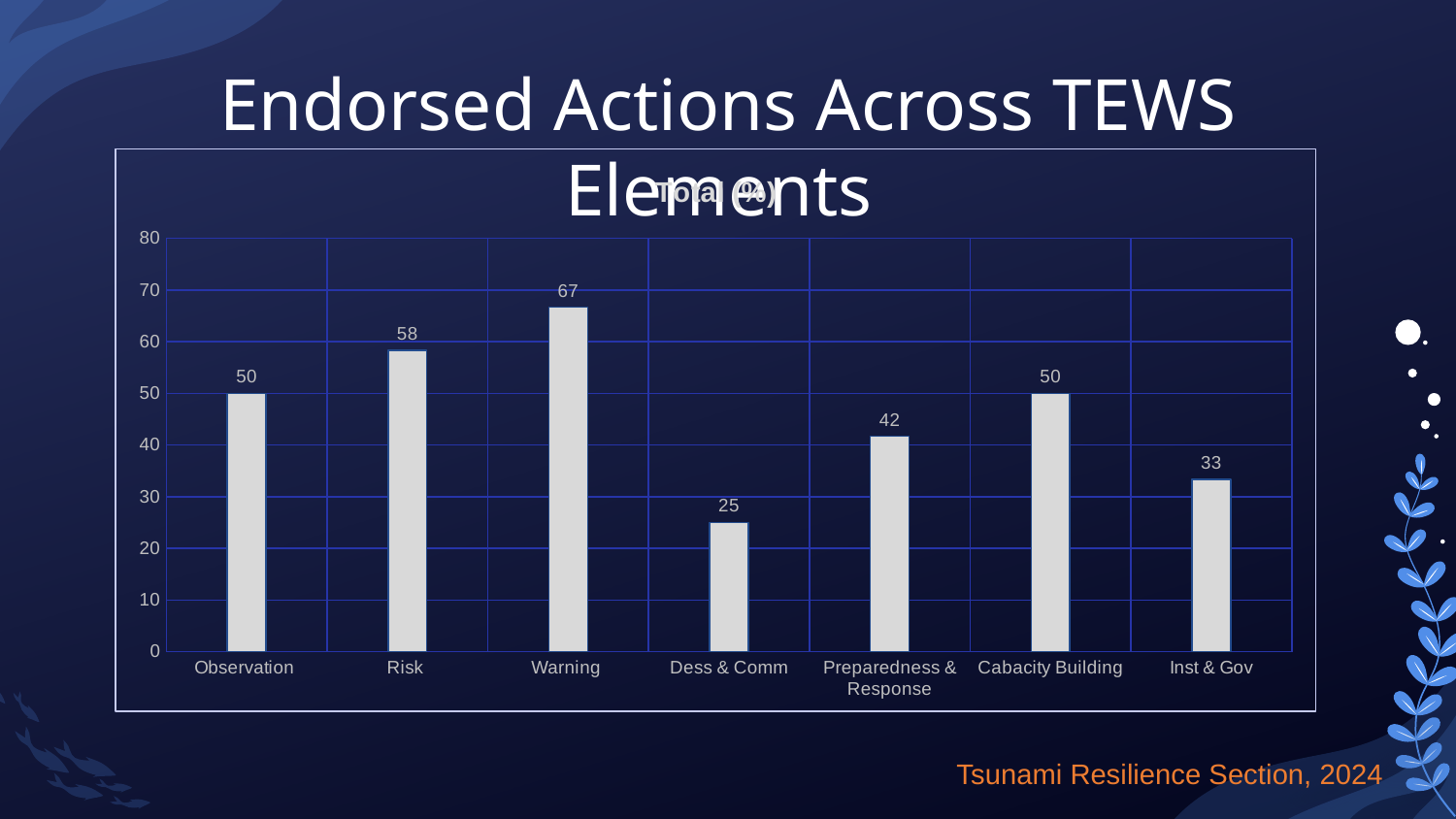
What kind of chart is shown on the slide? Bar chart Which is larger, the value for Risk or the value for Cabacity Building? Risk How many categories are shown on the x axis? 7 What is the difference between the values for Warning and Risk? 9 Which category has the highest value? Warning What is the value for Preparedness & Response? 42 What is the difference between the values for Preparedness & Response and Dess & Comm? 17 What is the value for Inst & Gov? 33 What is the value for Dess & Comm? 25 Which category has the lowest value? Dess & Comm What is the title of the slide? Endorsed Actions Across TEWS Elements What is the value for Warning? 67